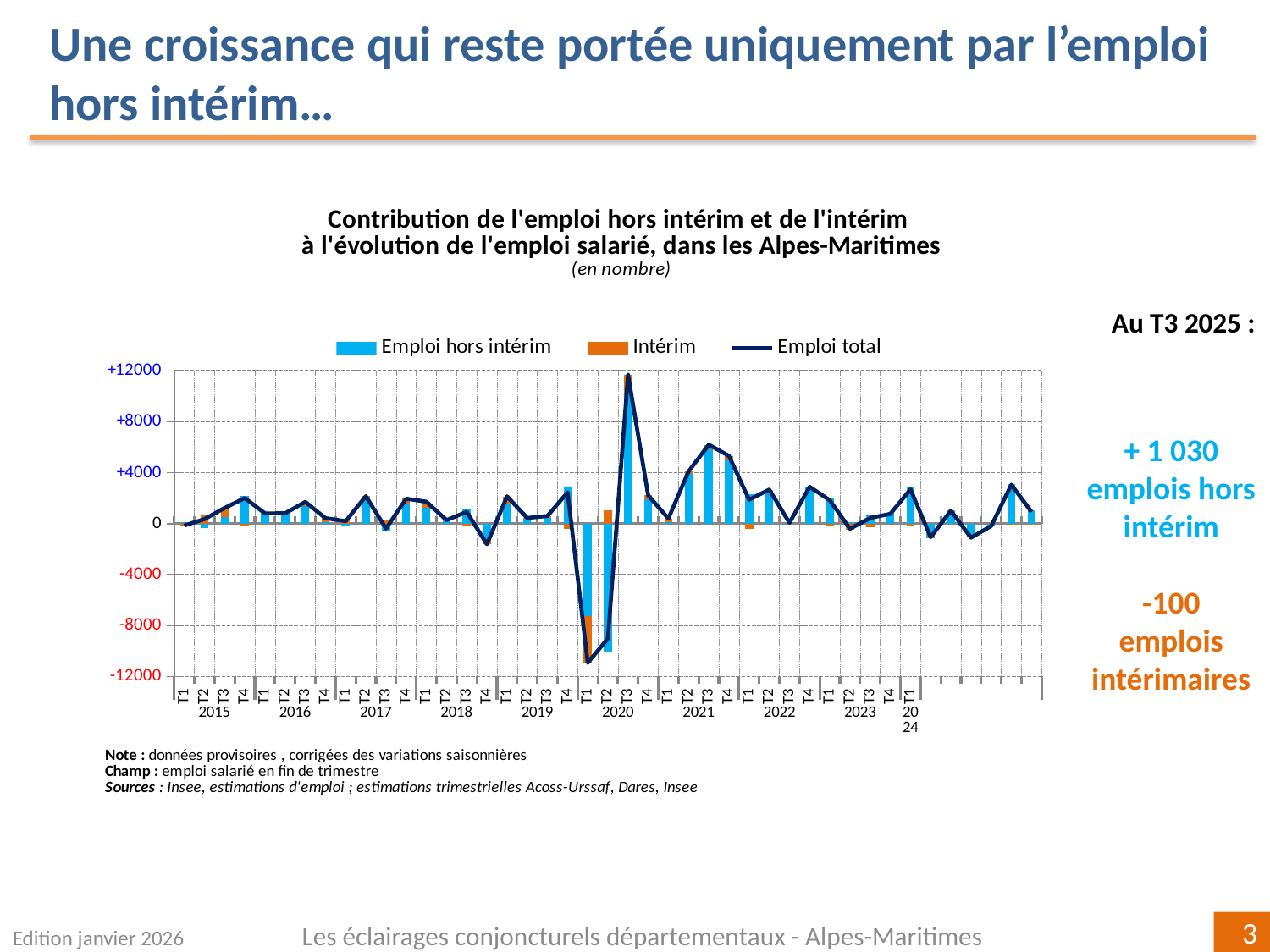
What are the three series named in the chart legend? Emploi hors intérim, Intérim, Emploi total According to the text on the right of the slide, what is the change in emplois intérimaires at T3 2025? -100 Which series is drawn as a dark line rather than bars? Emploi total How many series does the chart legend list? 3 Is the value of Emploi total at T3 2020 greater or less than +8000? greater Is the value of Emploi total at T1 2020 greater or less than -8000? less In which quarter does the Emploi total line reach its highest value? T3 2020 What kind of chart is shown on the slide? A combined bar and line chart According to the text on the right of the slide, what is the change in emplois hors intérim at T3 2025? + 1 030 Which is larger, the Emploi total value at T3 2020 or at T4 2021? T3 2020 In which quarter does the Emploi total line reach its lowest value? T1 2020 Is the value of Emploi total at T3 2021 greater or less than +4000? greater